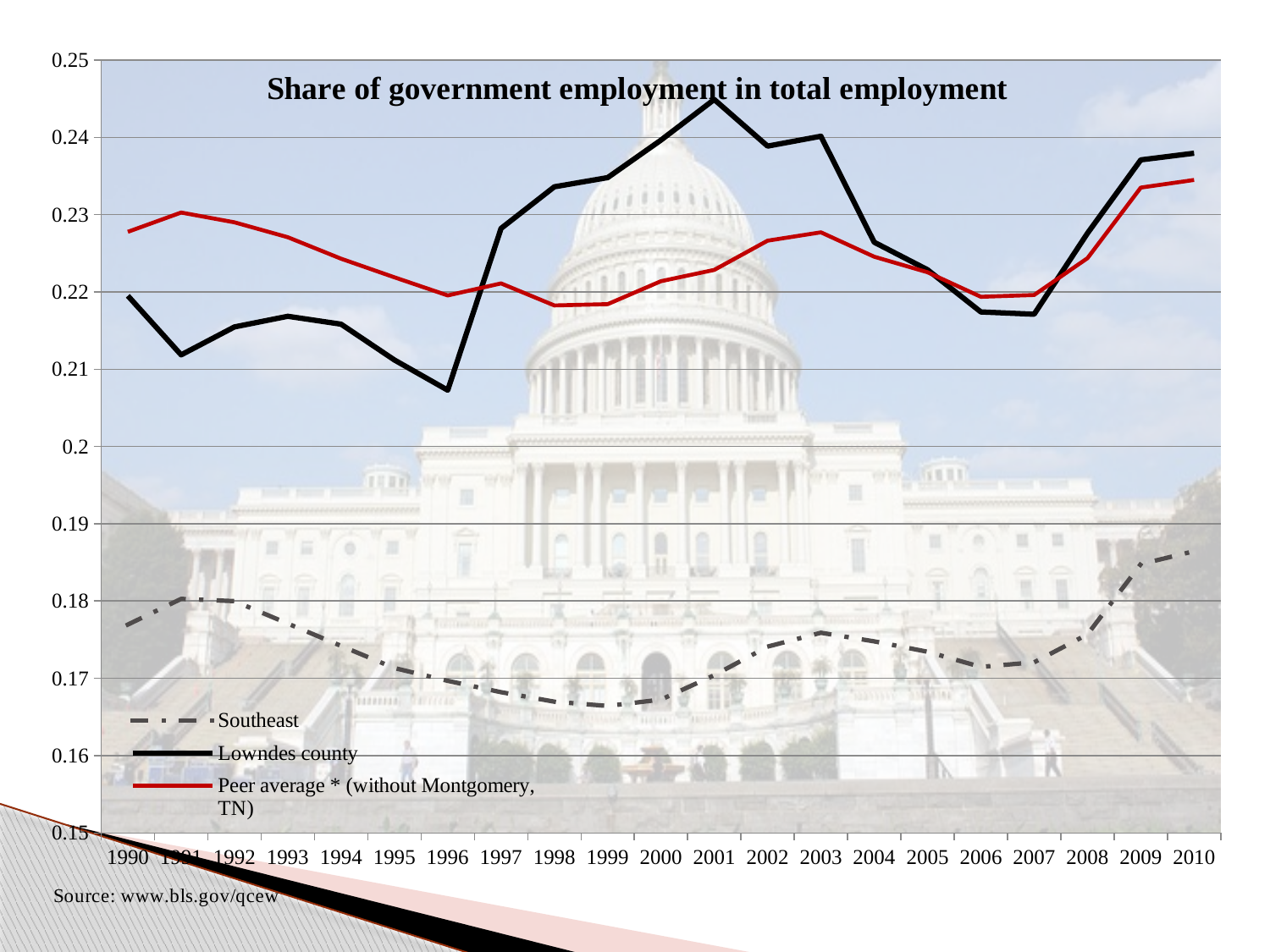
What kind of chart is shown on the slide? line chart In which year does the Southeast series reach its highest value? 2010 Is the value for Lowndes county in 2001 greater or less than 0.24? greater In which year does the Lowndes county series reach its highest value? 2001 In 1990, which is higher: Lowndes county or Peer average * (without Montgomery, TN)? Peer average * (without Montgomery, TN) Is the value for Lowndes county in 1996 greater or less than 0.21? less How many series does the legend list? 3 How many years are plotted along the x axis? 21 In which year does the Lowndes county series reach its lowest value? 1996 Is the value for Southeast in 1999 greater or less than 0.17? less Does the Southeast series rise or fall between 1991 and 1999? fall What is the title of the chart? Share of government employment in total employment